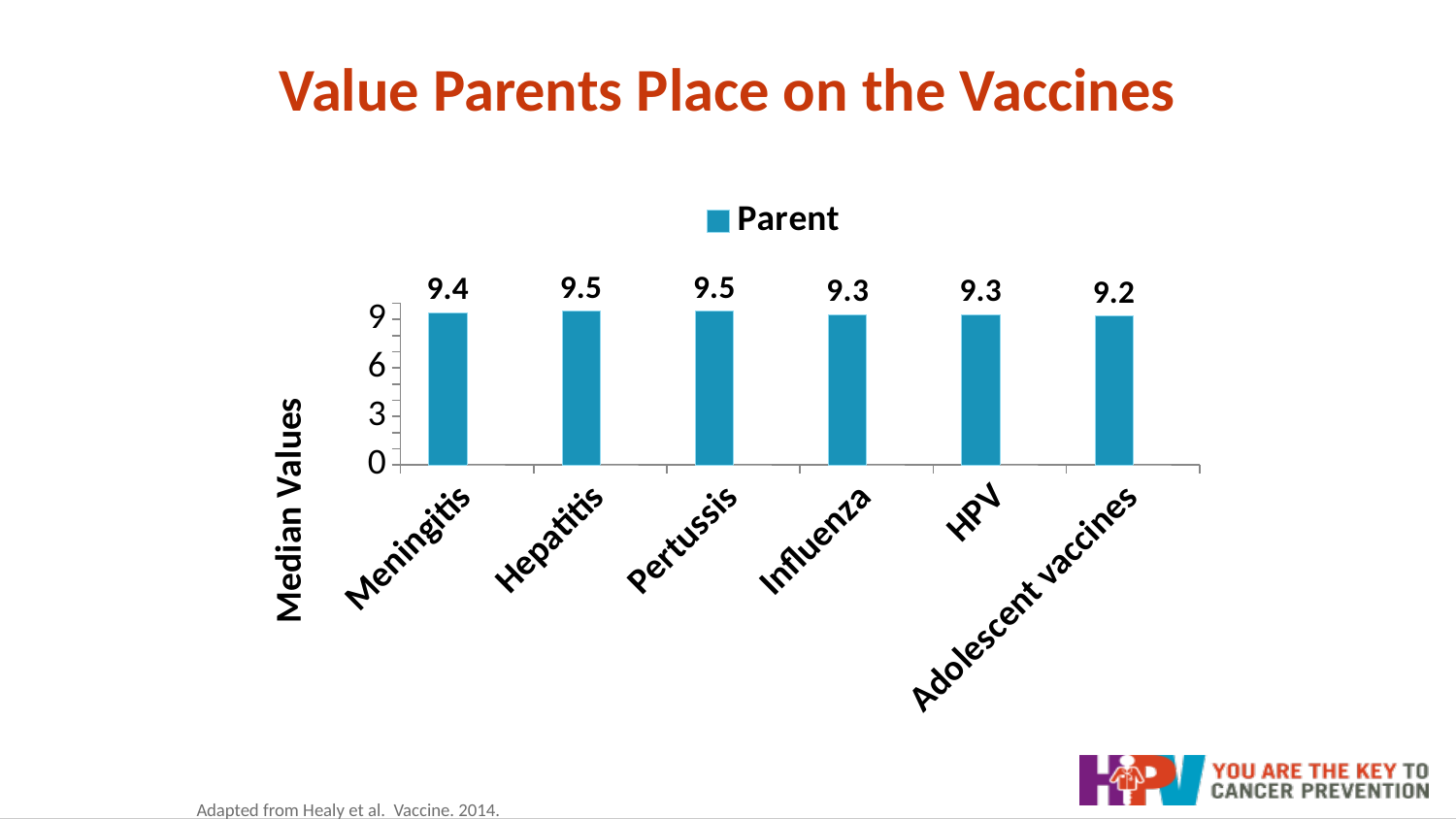
How many vaccine categories are shown on the x axis? 6 What is the label of the y axis? Median Values What kind of chart is shown on the slide? Bar chart Which has a higher median value, Meningitis or Adolescent vaccines? Meningitis How many series does the legend list? 1 What is the median value for Hepatitis? 9.5 What is the median value for Influenza? 9.3 What is the median value for Meningitis? 9.4 What is the median value for Adolescent vaccines? 9.2 Which vaccine has the lowest median value? Adolescent vaccines What is the median value for HPV? 9.3 What is the difference between the median values for Pertussis and Adolescent vaccines? 0.3